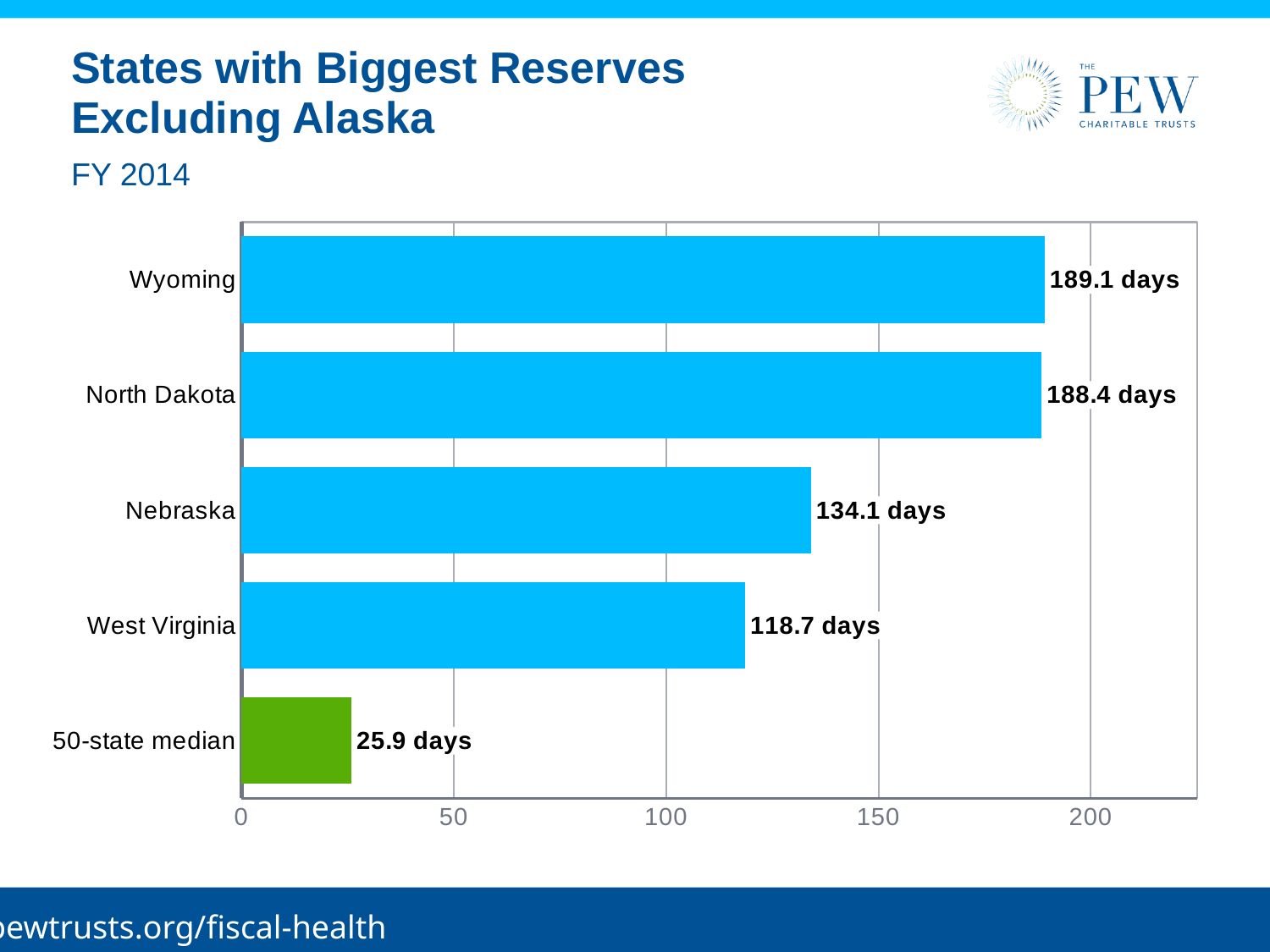
Which category has the lowest value? 50-state median What kind of chart is shown on the slide? Bar chart Which state has the highest value among the states shown? Wyoming Which bar is shown in a different colour (green) from the others? 50-state median What is the difference between Nebraska and West Virginia? 15.4 days What is the value for West Virginia? 118.7 days What is the value for the 50-state median? 25.9 days Which is larger, Nebraska or West Virginia? Nebraska What is the value for Wyoming? 189.1 days What is the difference between Wyoming and North Dakota? 0.7 days How many bars are shown in the chart? 5 What is the value for Nebraska? 134.1 days